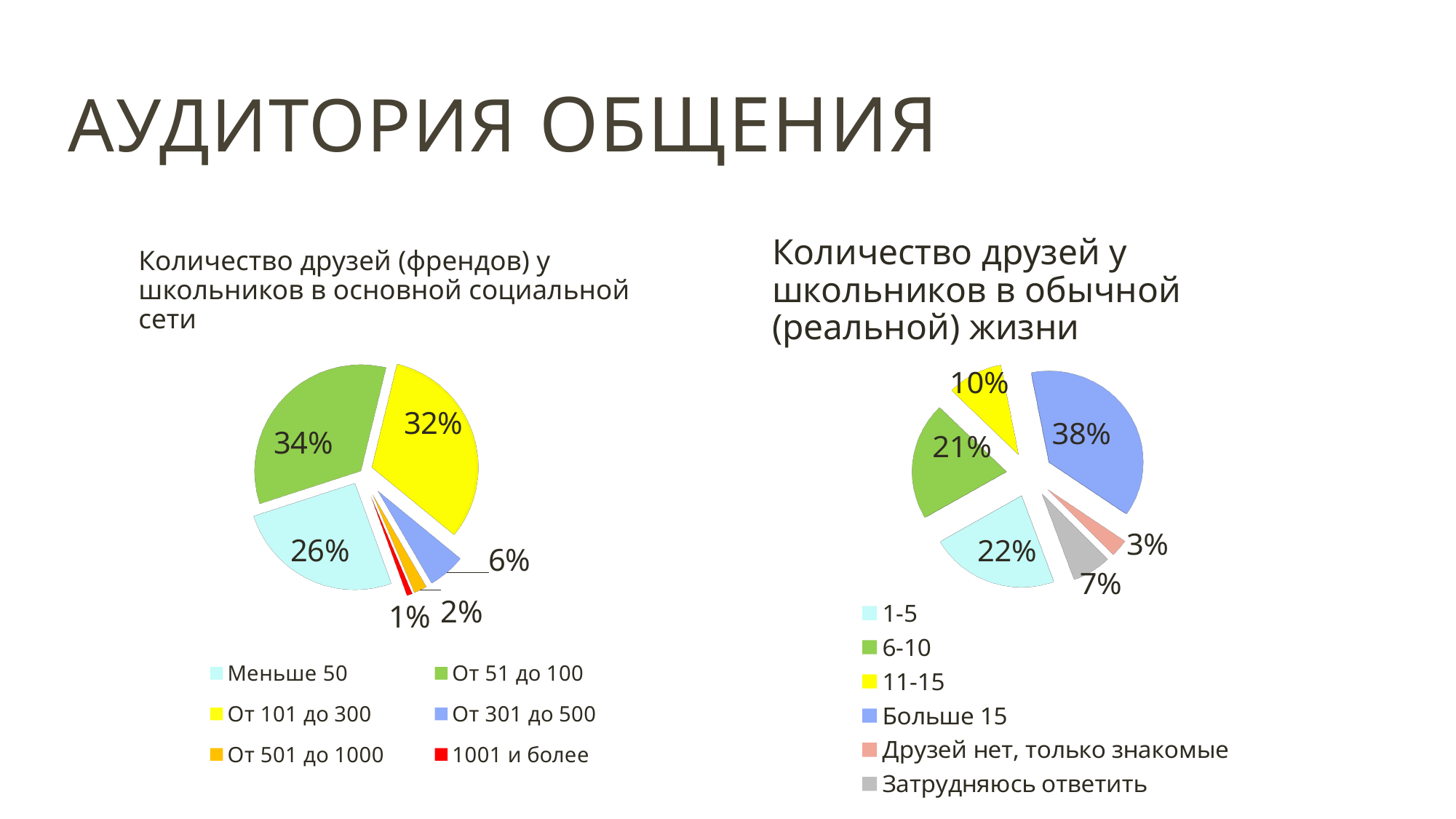
In the left pie chart (friends in the main social network), what share of schoolchildren have from 51 to 100 friends (От 51 до 100)? 34% How many categories does the legend of the left pie chart (friends in the main social network) list? 6 In the right pie chart (friends in real life), what share of schoolchildren have more than 15 friends (Больше 15)? 38% In the left pie chart (friends in the main social network), what is the difference between the shares for 'От 101 до 300' and 'От 301 до 500'? 26% In the right pie chart (friends in real life), what share corresponds to 'Затрудняюсь ответить'? 7% In the right pie chart (friends in real life), which is larger: the share for '1-5' or the share for '11-15'? 1-5 In the right pie chart (friends in real life), what is the combined share of '1-5' and '6-10'? 43% In the right pie chart (friends in real life), which category has the smallest share? Друзей нет, только знакомые In the left pie chart (friends in the main social network), which category has the largest share? От 51 до 100 In the left pie chart (friends in the main social network), which category has the smallest share? 1001 и более In the left pie chart (friends in the main social network), what share corresponds to 'Меньше 50'? 26% What type of chart is used on the right side of the slide (friends in real life)? Pie chart